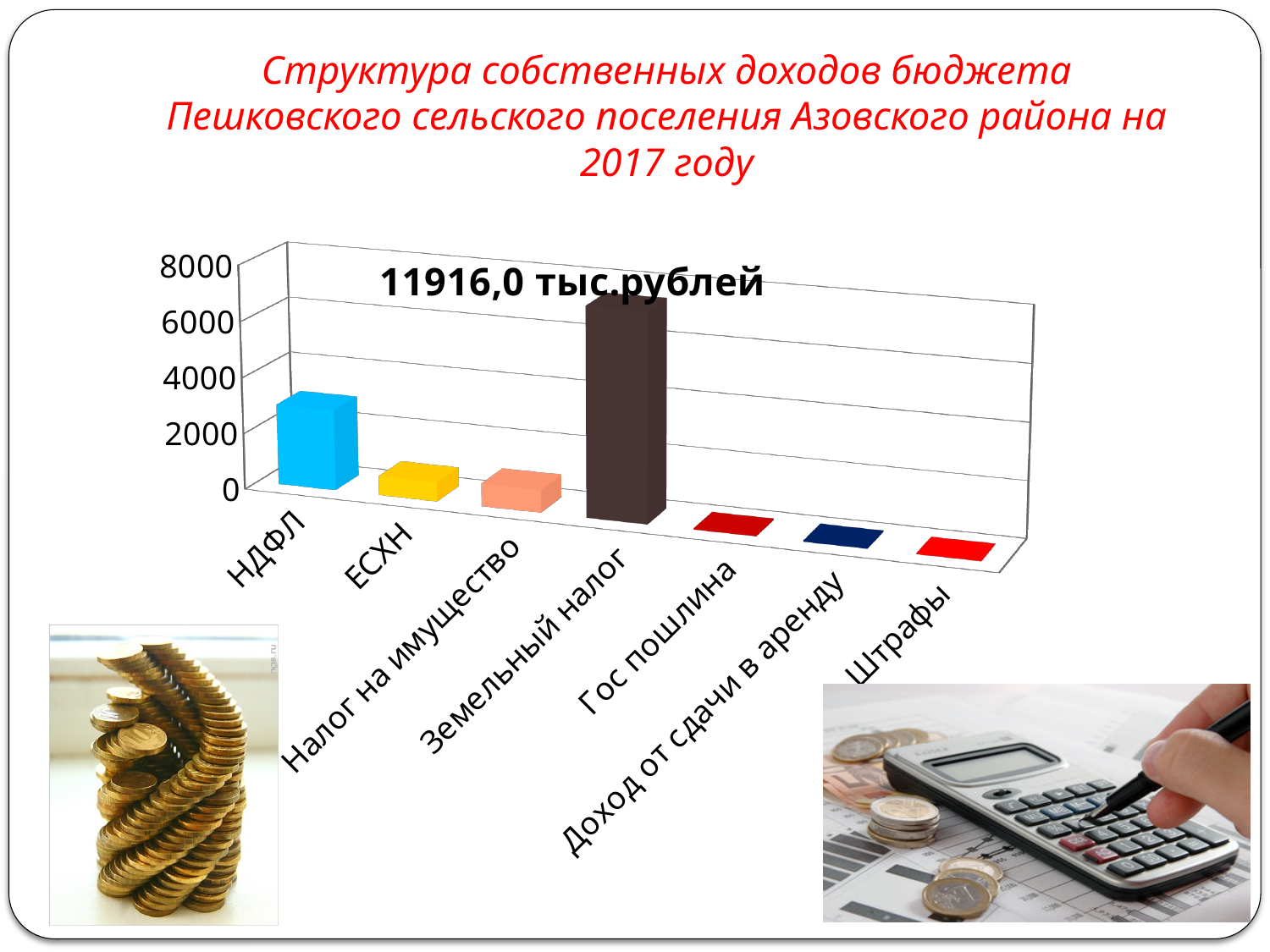
What total amount is printed as a text annotation inside the chart area? 11916,0 тыс.рублей Which is larger, the value for НДФЛ or the value for ЕСХН? НДФЛ Is the value for Земельный налог greater or less than 4000? greater How many categories are shown on the x axis of the chart? 7 Is the value for Налог на имущество greater or less than 2000? less Is the value for ЕСХН greater or less than 2000? less Which is larger, the value for Земельный налог or the value for НДФЛ? Земельный налог What kind of chart is shown on the slide? bar chart What is the highest value shown on the vertical axis of the chart? 8000 Which category has the highest bar in the chart? Земельный налог